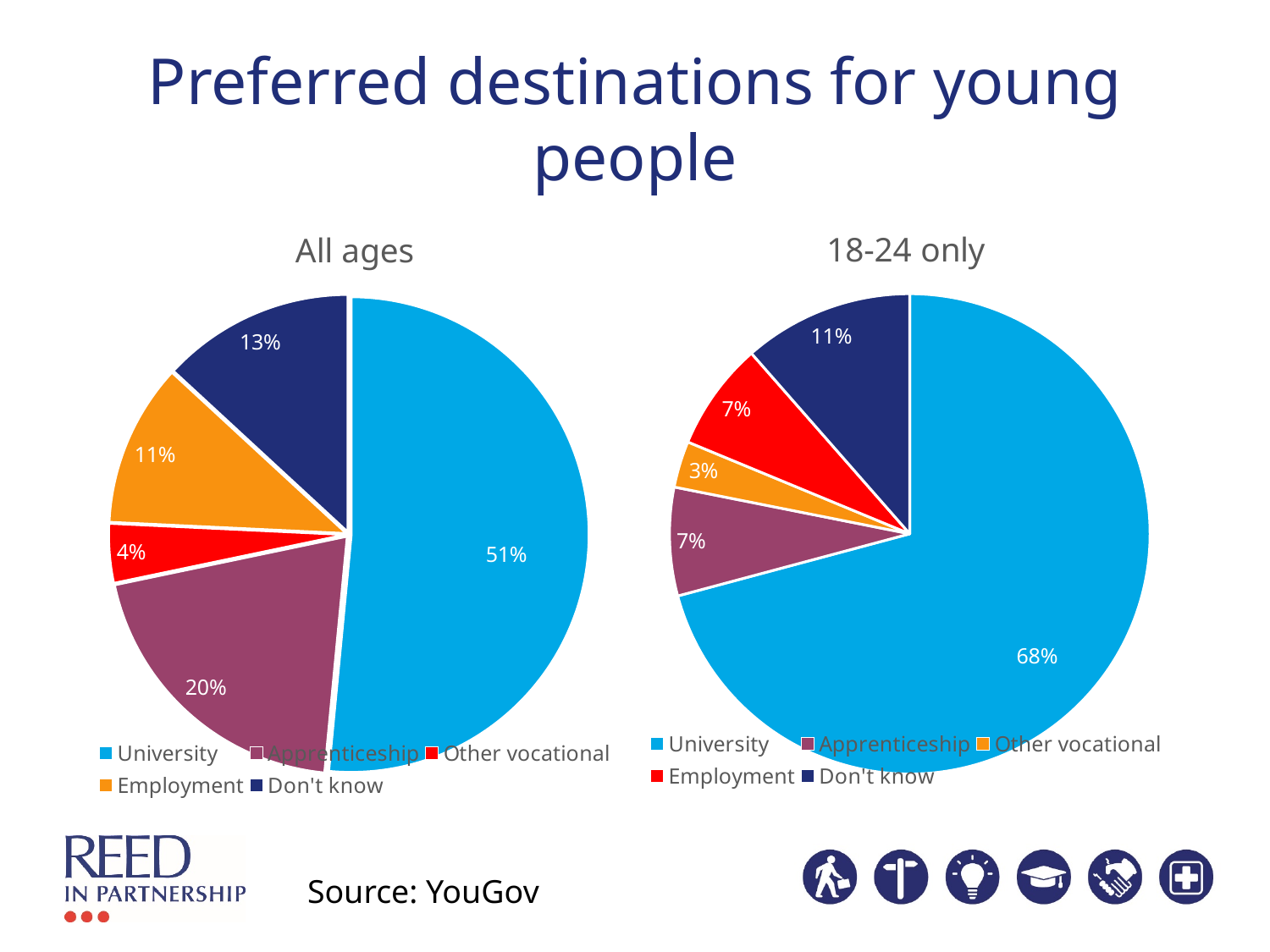
In the '18-24 only' pie chart, which category has the largest share? University Which is larger: the Apprenticeship share in the 'All ages' chart or in the '18-24 only' chart? All ages In the 'All ages' pie chart, what percentage chose University? 51% In the 'All ages' pie chart, which category has the smallest share? Other vocational In the 'All ages' pie chart, what share is Apprenticeship? 20% What type of chart is used for 'All ages' and '18-24 only'? Pie chart In the '18-24 only' pie chart, what percentage is Other vocational? 3% How many categories does the legend of the 'All ages' chart list? 5 What is the difference between the University share in the '18-24 only' chart and the University share in the 'All ages' chart? 17% In the '18-24 only' pie chart, what percentage is Don't know? 11% In the '18-24 only' pie chart, what percentage chose University? 68% In the 'All ages' pie chart, what percentage is Employment? 11%